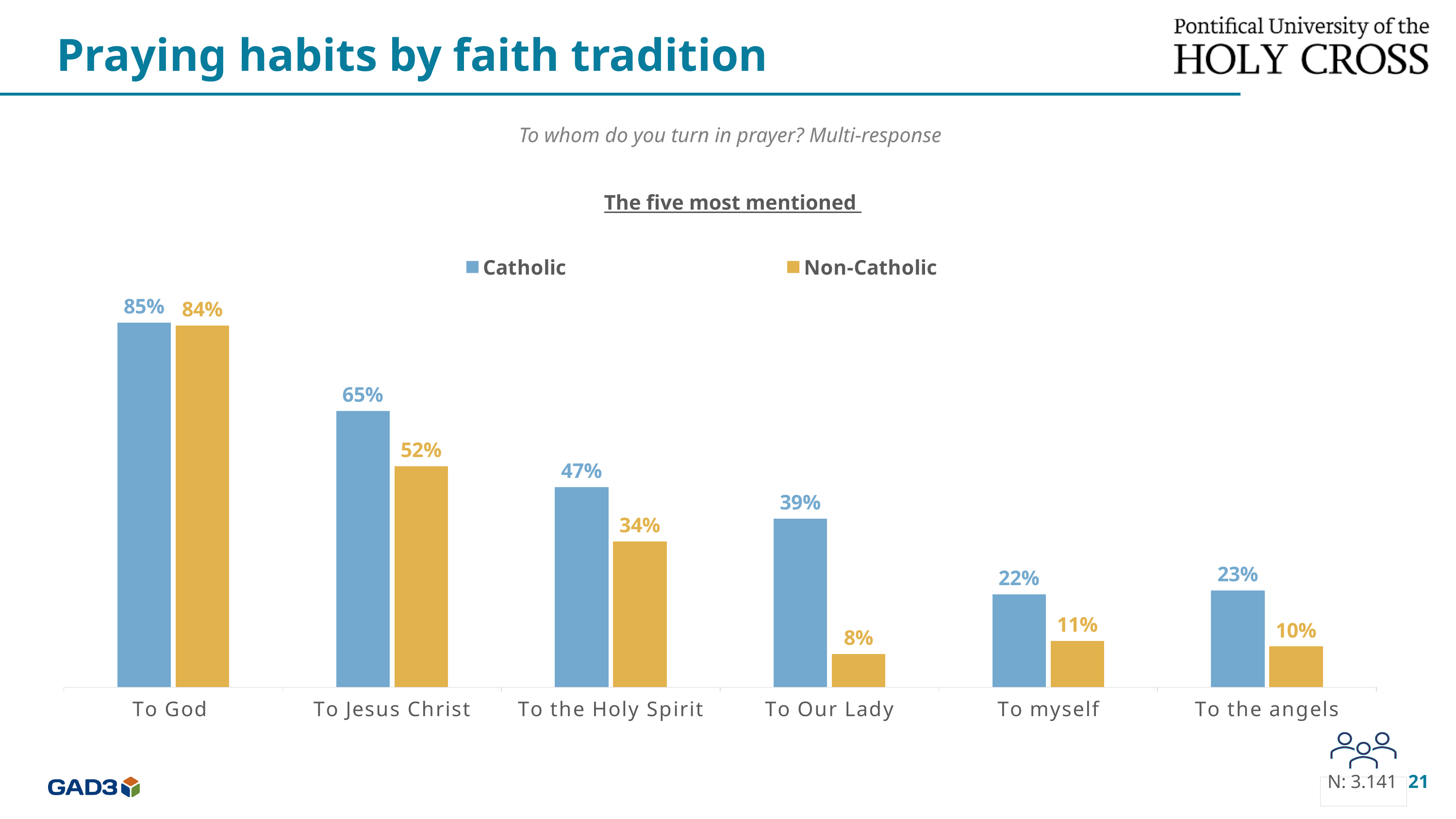
Which is larger for 'To Our Lady': the Catholic value or the Non-Catholic value? Catholic How many categories are shown on the x axis? 6 What is the difference between the Catholic and Non-Catholic values for 'To the Holy Spirit'? 13% Which category has the highest Catholic value? To God Which category has the lowest Non-Catholic value? To Our Lady Which colour represents the Non-Catholic series? Yellow/orange What is the Catholic value for 'To the angels'? 23% What percentage of Non-Catholics turn to Jesus Christ in prayer? 52% What kind of chart is shown on the slide? Bar chart How many series does the legend list? 2 What percentage of Catholics say they turn to God in prayer? 85% What is the Non-Catholic value for 'To Our Lady'? 8%